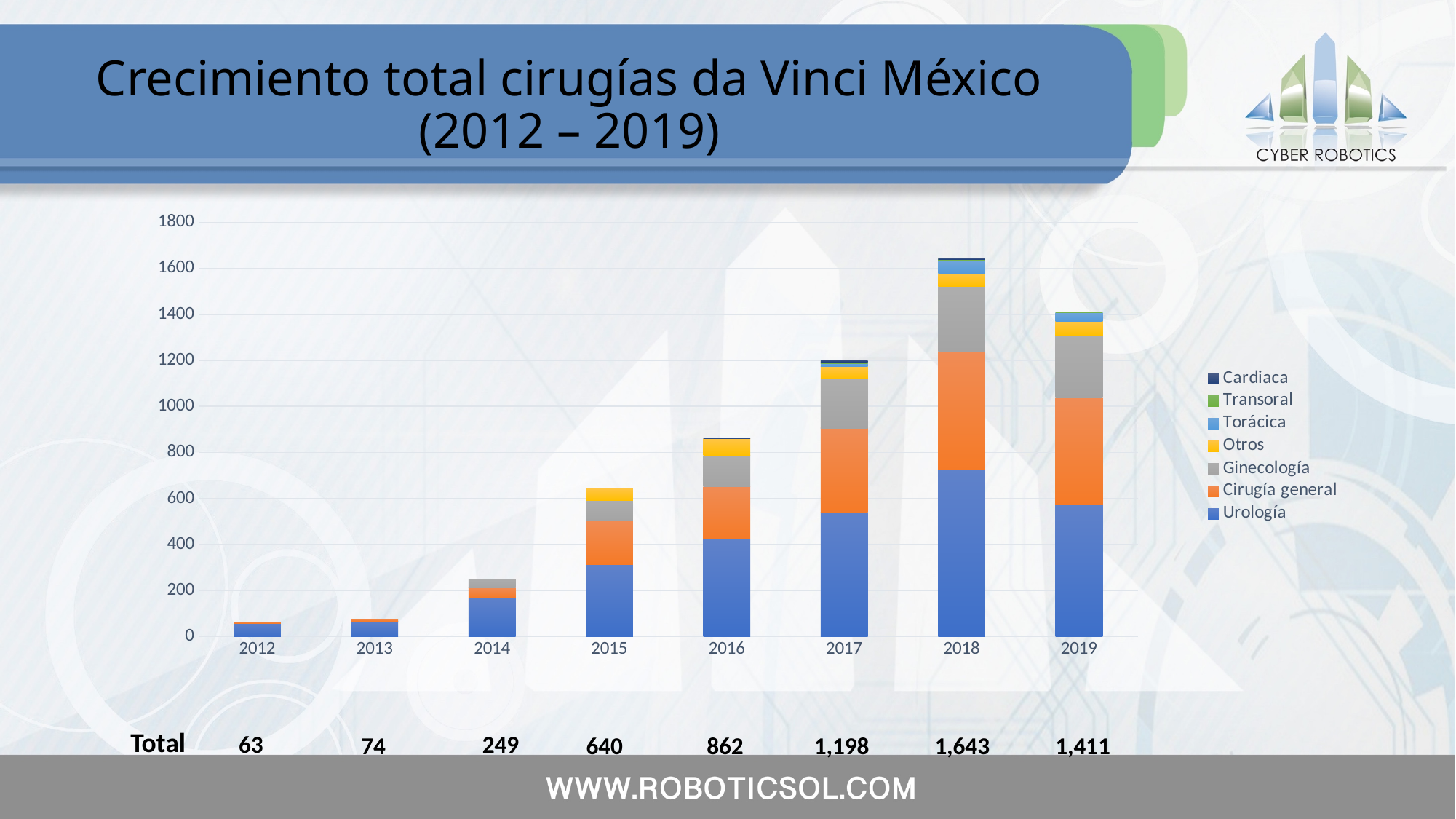
What is the total number of surgeries shown for 2018? 1,643 What is the total number of surgeries shown for 2016? 862 Which year has the highest total of surgeries? 2018 Which year has the lowest total of surgeries? 2012 Which series is shown in orange in the chart? Cirugía general What type of chart is shown on the slide? stacked bar chart What is the difference between the totals for 2018 and 2019? 232 Is the Urología value for 2018 greater or less than 600? greater What is the total number of surgeries shown for 2012? 63 How many series does the chart's legend list? 7 How many years (categories) are shown on the x axis of the chart? 8 Which year has a larger total, 2015 or 2017? 2017